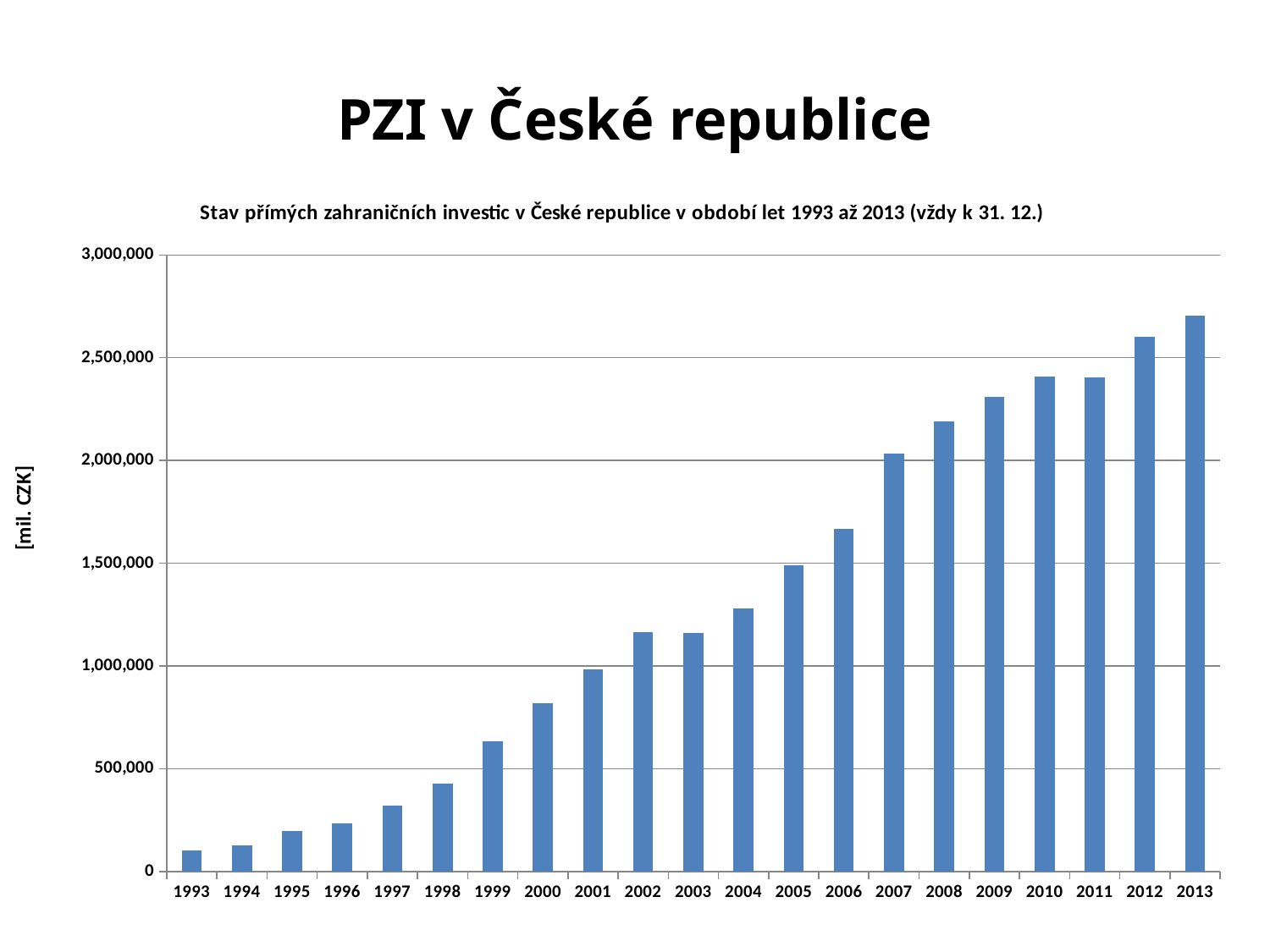
What kind of chart is shown on the slide? bar chart Is the value for 2013 greater or less than 2,500,000? greater Is the value for 1999 greater or less than 500,000? greater How many years (bars) are shown in the chart? 21 Which year has the highest value in the chart? 2013 What unit is shown on the vertical axis label? [mil. CZK] Is the value for 2006 greater or less than 2,000,000? less Which year has the larger value, 2008 or 2012? 2012 Do the values generally rise or fall from 1993 to 2013? rise Which year has the lowest value in the chart? 1993